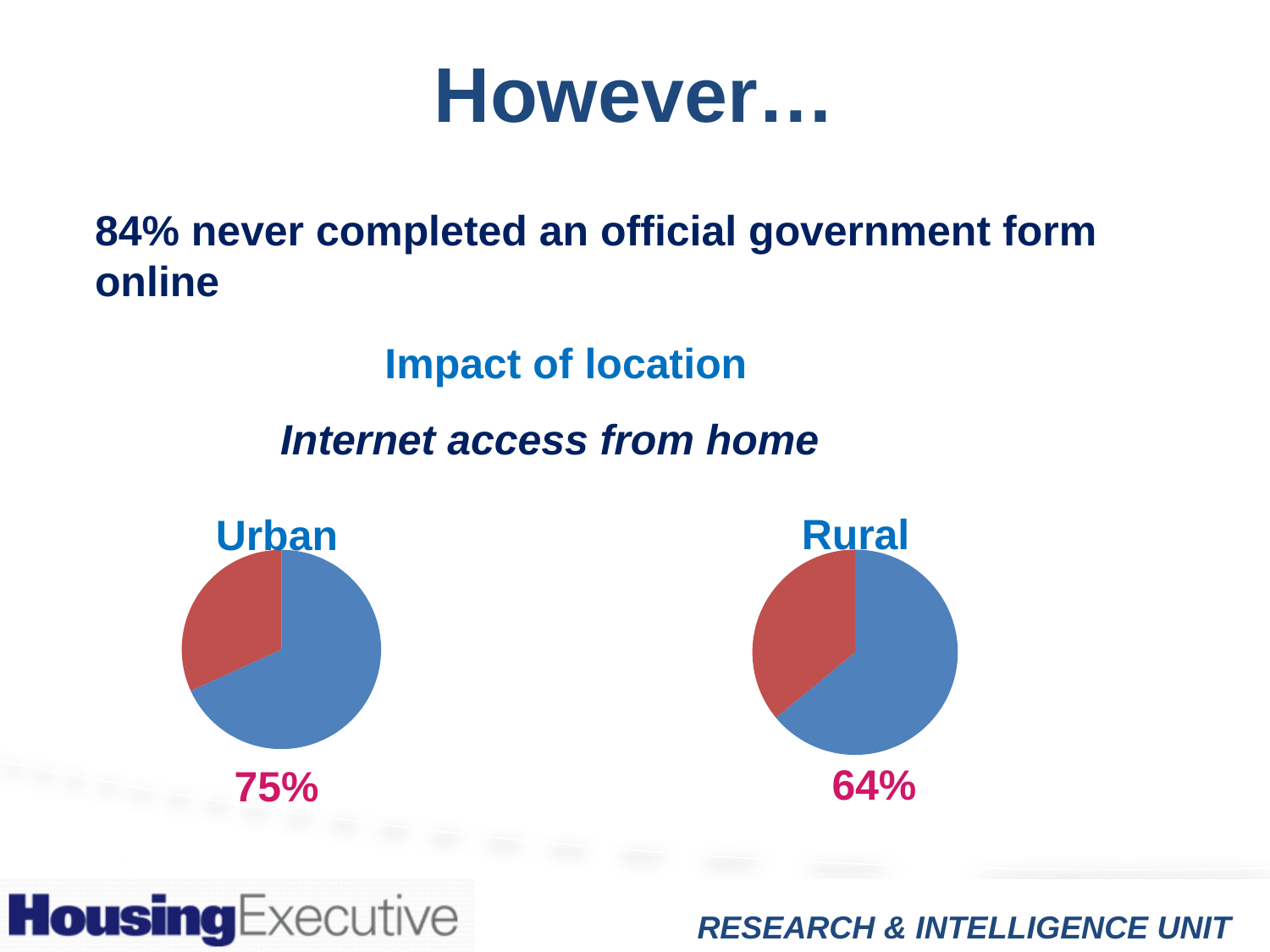
In the Urban pie chart, what percentage is shown for internet access from home? 75% What is the title given above the two pie charts describing what they measure? Internet access from home In the Rural pie chart, what share of the pie does the larger (blue) slice represent? 64% How many pie charts are shown on the slide? 2 In the Rural pie chart, what percentage is shown for internet access from home? 64% How many slices does the Urban pie chart have? 2 What is the difference in percentage points between the Urban (75%) and Rural (64%) internet access figures? 11 percentage points In the Urban pie chart, which colour is the larger slice? Blue Comparing the Urban and Rural pie charts, which location has the higher percentage of internet access from home? Urban What kind of chart is used to show internet access from home for Urban and Rural locations? Pie chart Comparing the Urban and Rural pie charts, which location has the lower percentage of internet access from home? Rural